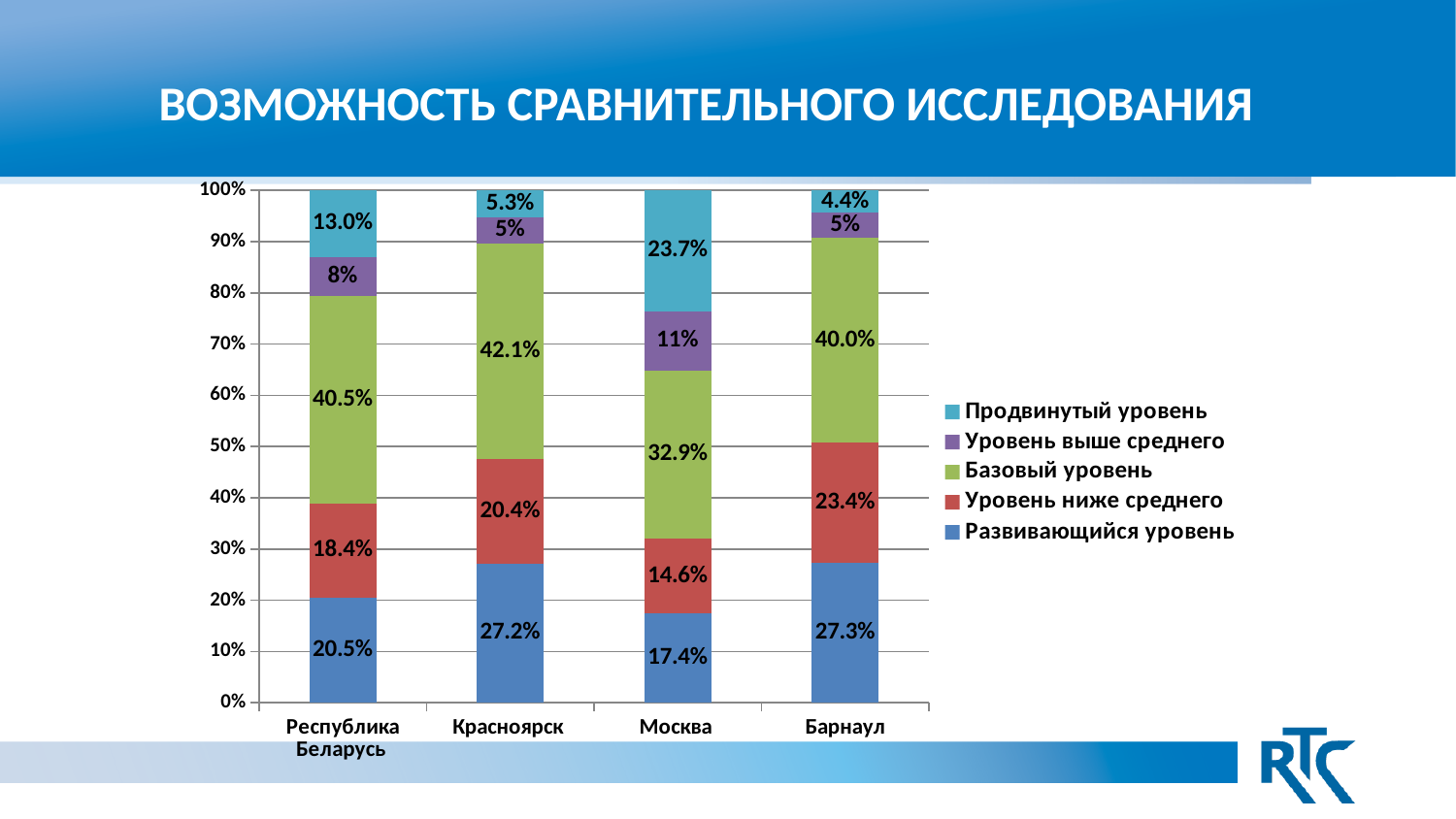
What is the difference between the Базовый уровень values for Красноярск and Республика Беларусь? 1.6 percentage points What kind of chart is shown on the slide? Stacked bar chart What is the value of Уровень ниже среднего for Красноярск? 20.4% How many series does the legend list? 5 Which is larger: Уровень ниже среднего for Барнаул or for Москва? Барнаул What is the value of Базовый уровень for Москва? 32.9% Which series is shown in green in the legend? Базовый уровень What is the value of Развивающийся уровень for Республика Беларусь? 20.5% Which category has the highest value for Продвинутый уровень? Москва How many categories are shown on the x axis? 4 Which category has the lowest value for Развивающийся уровень? Москва What is the value of Продвинутый уровень for Барнаул? 4.4%